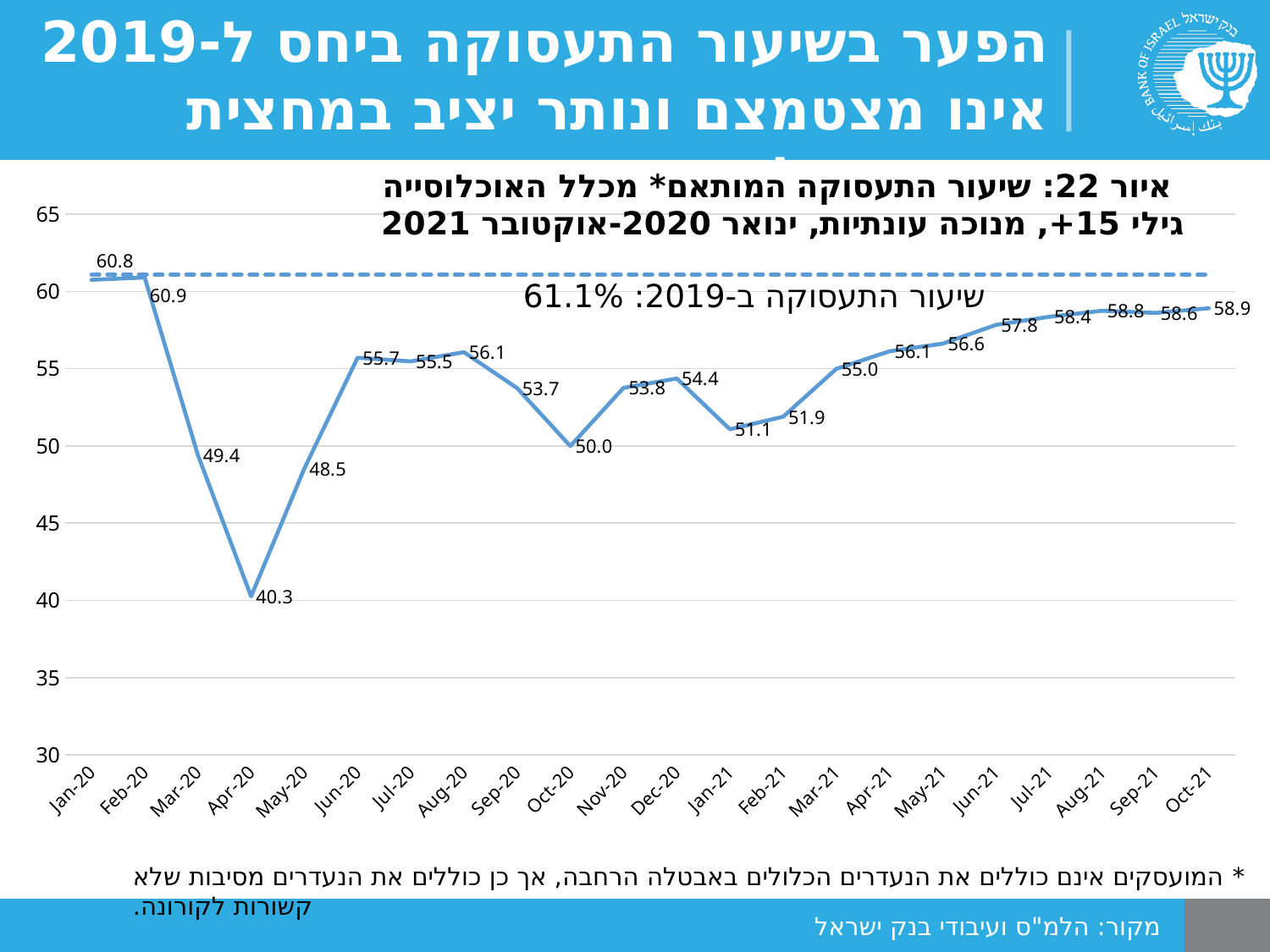
Which is larger, the value for Jun-20 or the value for Jul-20? Jun-20 Which month has the highest value? Feb-20 What is the difference between the values for Feb-20 and Apr-20? 20.6 What is the value for Oct-20? 50.0 What 2019 employment rate does the dashed reference line represent? 61.1% How many months are plotted on the x axis? 22 Is the value for Mar-20 greater or less than 50? less Which month has the lowest value? Apr-20 What is the value for Apr-20? 40.3 What type of chart is shown on the slide? line chart Do the values rise or fall from Jan-21 to Oct-21? rise What is the value for Oct-21? 58.9